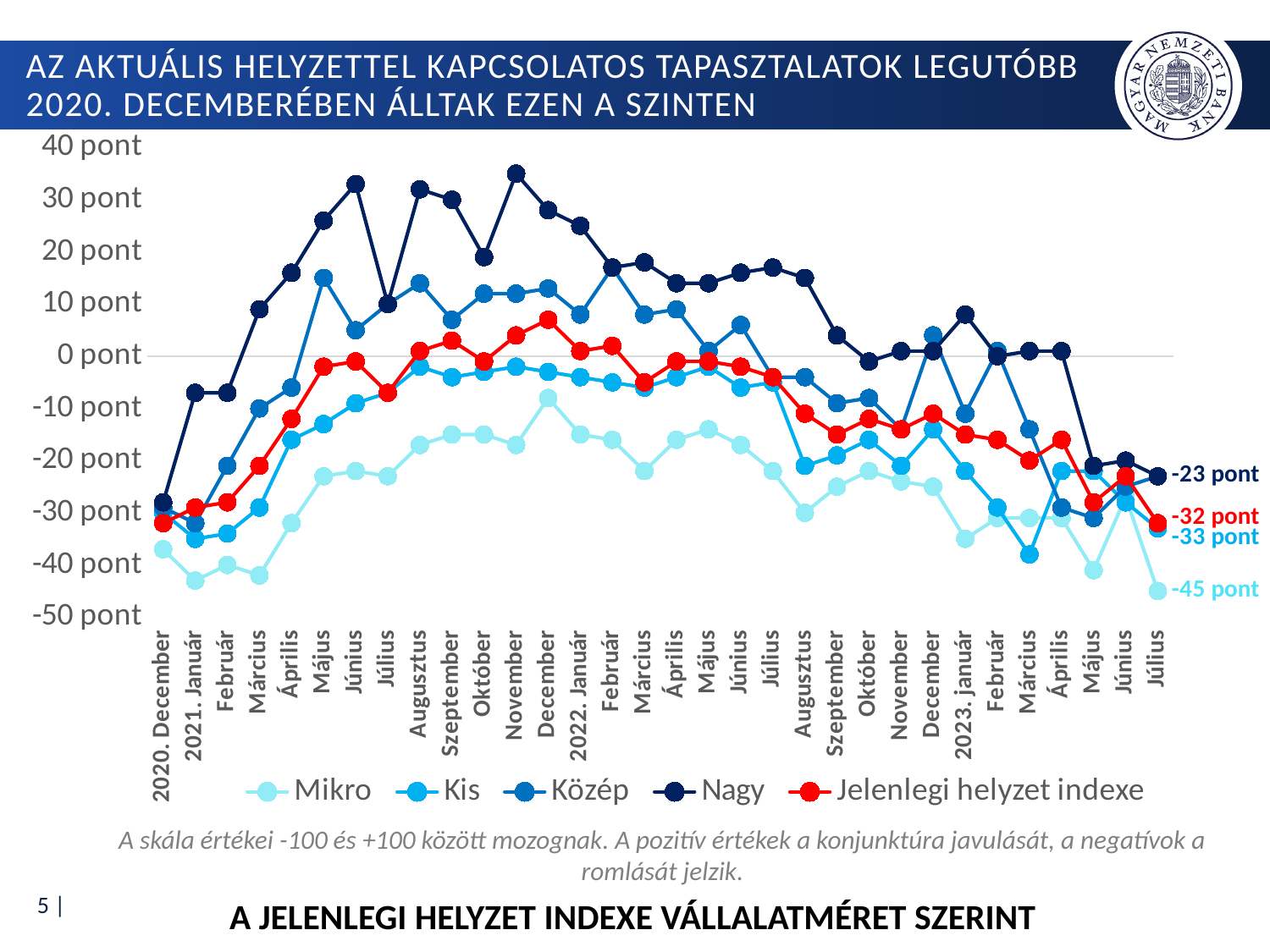
Which is larger in 2021 Június: the Nagy value or the Mikro value? Nagy What is the difference between the Nagy value (-23 pont) and the Jelenlegi helyzet indexe value (-32 pont) in 2023 Július? 9 pont Is the value for the Mikro series in 2021 Január greater or less than -40 pont? less How many series does the legend list? 5 What kind of chart is shown on the slide? line chart Is the value for the Nagy series in 2021 November greater or less than 30 pont? greater What is the difference between the Nagy value (-23 pont) and the Mikro value (-45 pont) in 2023 Július? 22 pont Which series has the highest value in 2023 Július? Nagy and Közép (both -23 pont) Which series has the lowest value in 2023 Július? Mikro What is the value of the Jelenlegi helyzet indexe series in 2023 Július? -32 pont What is the value of the Nagy series in 2023 Július? -23 pont What is the value of the Mikro series in 2023 Július? -45 pont